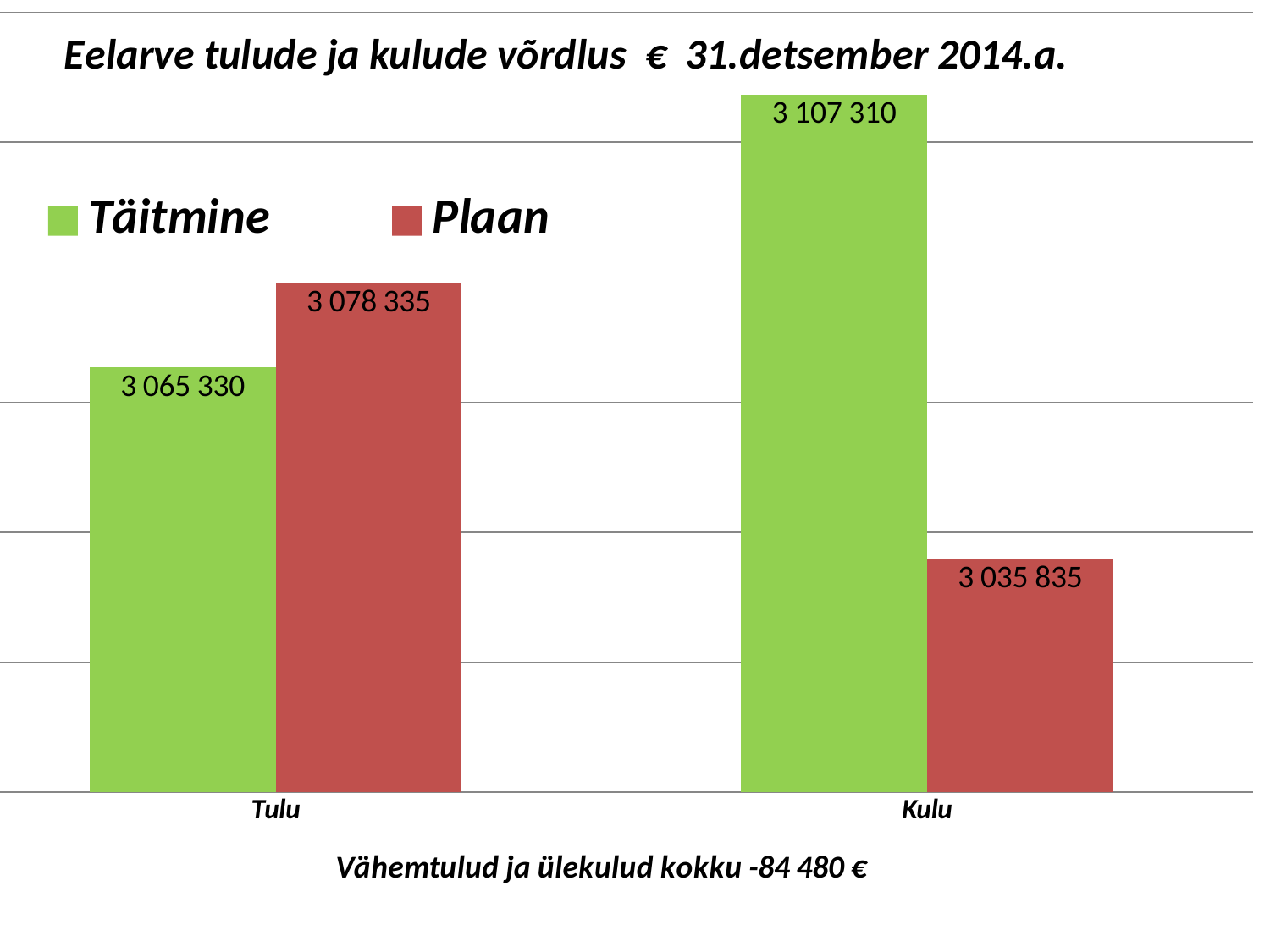
What is the Täitmine value for Tulu? 3 065 330 Which bar has the highest value on the chart? Täitmine for Kulu What is the difference between the Plaan and Täitmine values for Tulu? 13 005 Which bar has the lowest value on the chart? Plaan for Kulu What kind of chart is shown on the slide? Bar chart What is the difference between the Täitmine and Plaan values for Kulu? 71 475 What is the Täitmine value for Kulu? 3 107 310 How many series does the legend list? 2 What is the Plaan value for Tulu? 3 078 335 What is the Plaan value for Kulu? 3 035 835 How many categories are shown on the x axis? 2 For Kulu, which is larger: Täitmine or Plaan? Täitmine